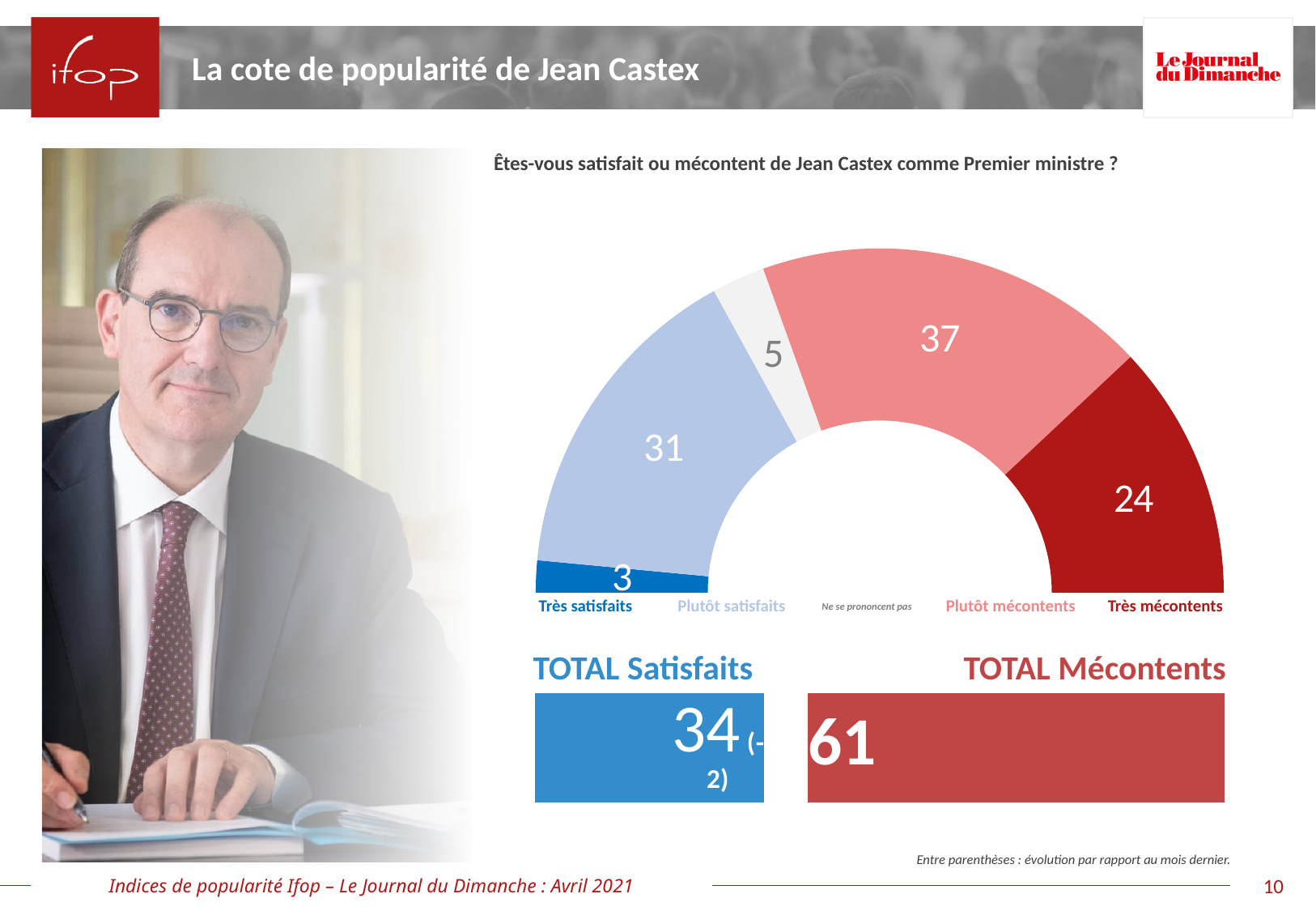
How many categories are shown in the chart? 5 What value is shown for "Ne se prononcent pas"? 5 Which is larger, the value for "Plutôt satisfaits" or the value for "Très mécontents"? Plutôt satisfaits What is the value shown for "TOTAL Mécontents"? 61 What value is shown for "Très satisfaits"? 3 What value is shown for "Très mécontents"? 24 Which category has the lowest value in the chart? Très satisfaits What is the difference between the values for "Plutôt mécontents" and "Très mécontents"? 13 What value is shown for "Plutôt satisfaits"? 31 What value is shown for "Plutôt mécontents"? 37 What kind of chart is used to show the satisfaction responses? Doughnut chart (semi-circular) Which category has the highest value in the chart? Plutôt mécontents